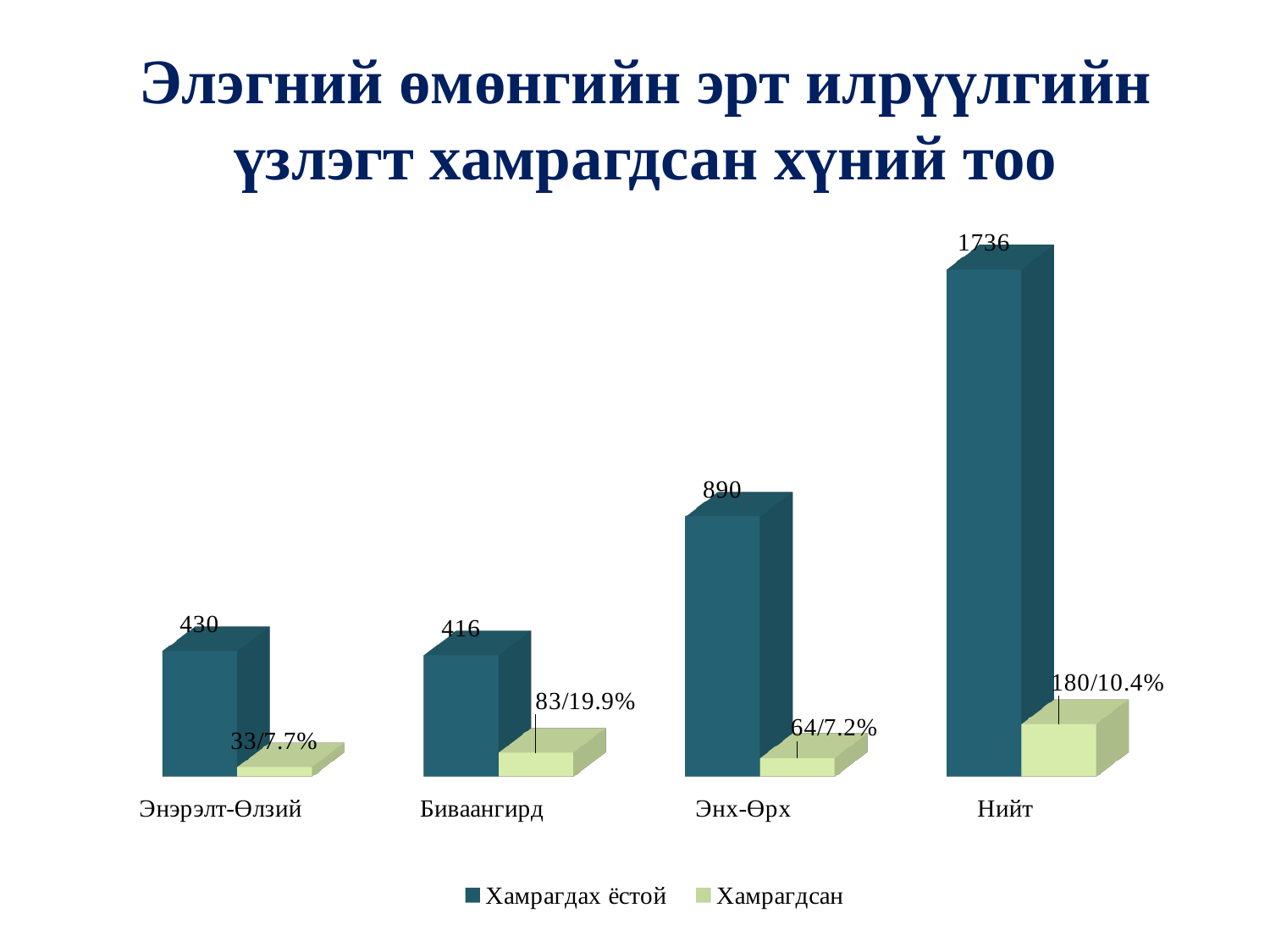
How many categories are shown on the x axis? 4 Which category has the lowest Хамрагдах ёстой value? Биваангирд What is the difference between the Хамрагдах ёстой values for Энх-Өрх and Энэрэлт-Өлзий? 460 Which category has the highest Хамрагдах ёстой value? Нийт What data label is shown for Хамрагдсан for Энэрэлт-Өлзий? 33/7.7% What is the value of Хамрагдах ёстой for Нийт? 1736 How many series does the legend list? 2 What kind of chart is shown on the slide? Bar chart What is the value of Хамрагдах ёстой for Энх-Өрх? 890 What are the two series names listed in the legend? Хамрагдах ёстой and Хамрагдсан Which is larger, the Хамрагдах ёстой value for Энэрэлт-Өлзий or for Биваангирд? Энэрэлт-Өлзий What data label is shown for Хамрагдсан for Биваангирд? 83/19.9%